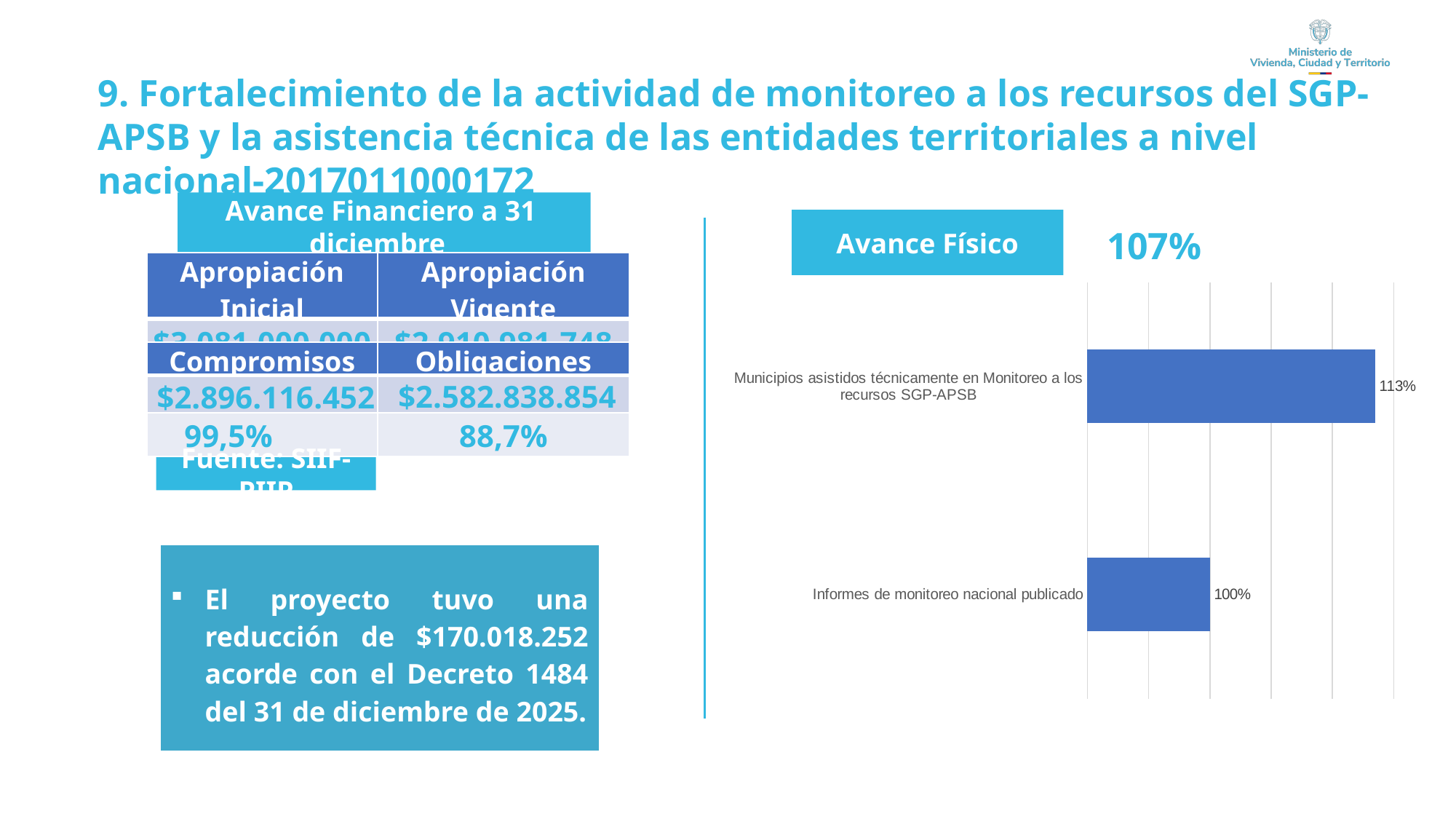
What is the value for "Municipios asistidos técnicamente en Monitoreo a los recursos SGP-APSB" in the Avance Físico chart? 113% What is the value for "Informes de monitoreo nacional publicado" in the Avance Físico chart? 100% What is the difference between the values for "Municipios asistidos técnicamente en Monitoreo a los recursos SGP-APSB" and "Informes de monitoreo nacional publicado" in the Avance Físico chart? 13% What overall percentage is displayed next to the Avance Físico title? 107% Which category has the highest value in the Avance Físico chart? Municipios asistidos técnicamente en Monitoreo a los recursos SGP-APSB Which category has the lowest value in the Avance Físico chart? Informes de monitoreo nacional publicado How many categories are shown in the Avance Físico chart? 2 In the Avance Físico chart, which is larger: the value for "Municipios asistidos técnicamente en Monitoreo a los recursos SGP-APSB" or for "Informes de monitoreo nacional publicado"? Municipios asistidos técnicamente en Monitoreo a los recursos SGP-APSB What kind of chart is the Avance Físico chart? Bar chart What is the title shown above the bar chart on the right of the slide? Avance Físico